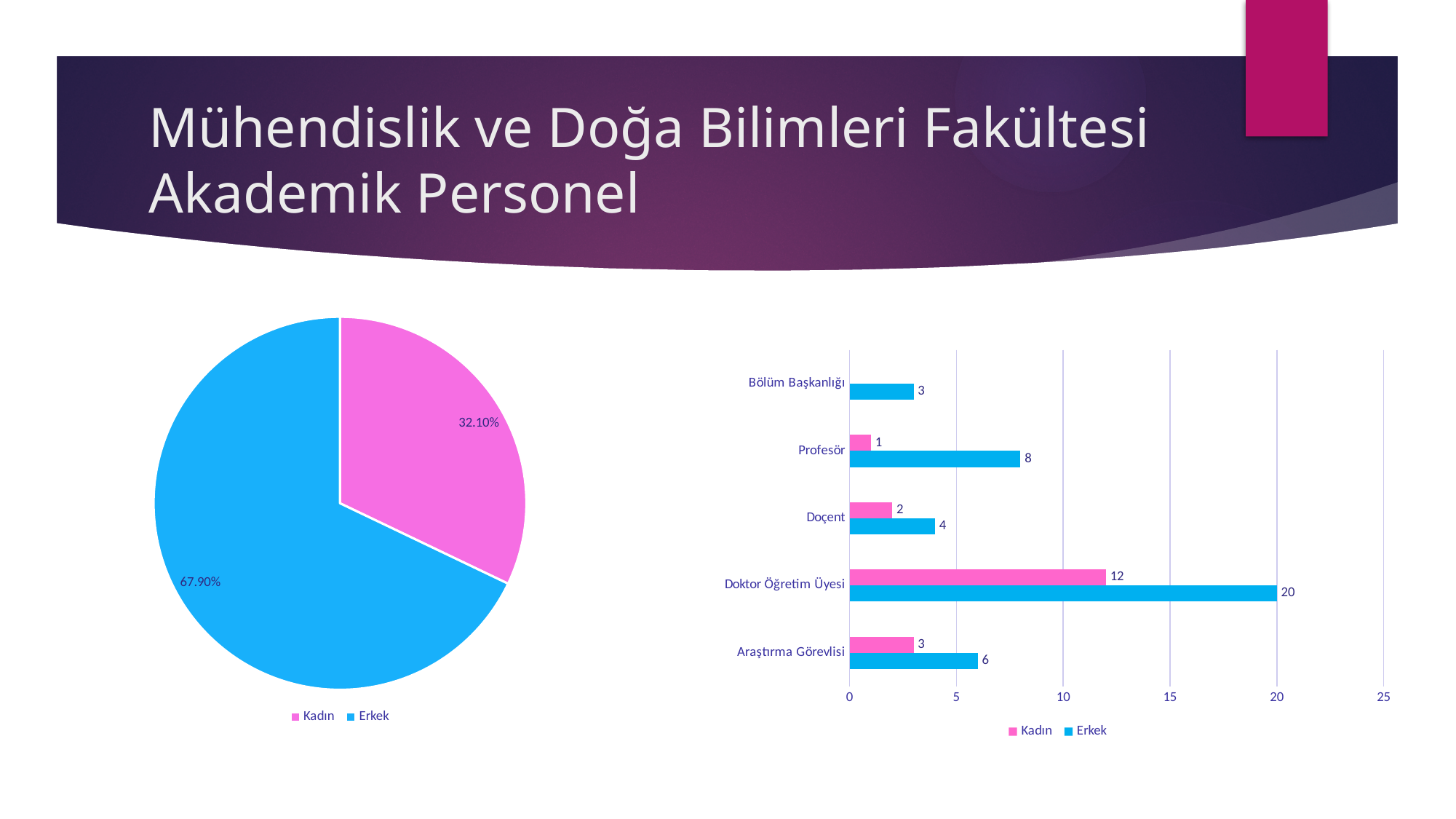
What kind of chart is shown on the right side of the slide? Bar chart In the bar chart on the right, which category has the lowest Kadın value among those with a Kadın bar? Profesör In the bar chart on the right, what is the Kadın value for Profesör? 1 How many series does the legend of the bar chart on the right list? 2 In the bar chart on the right, what is the Erkek value for Bölüm Başkanlığı? 3 In the bar chart on the right, which category has the highest Erkek value? Doktor Öğretim Üyesi In the bar chart on the right, what is the difference between the Erkek and Kadın values for Doktor Öğretim Üyesi? 8 In the pie chart on the left, what share does Erkek have? 67.90% In the pie chart on the left, what share does Kadın have? 32.10% In the bar chart on the right, what is the Erkek value for Doktor Öğretim Üyesi? 20 In the pie chart on the left, which slice is larger, Kadın or Erkek? Erkek How many categories are shown on the bar chart on the right? 5